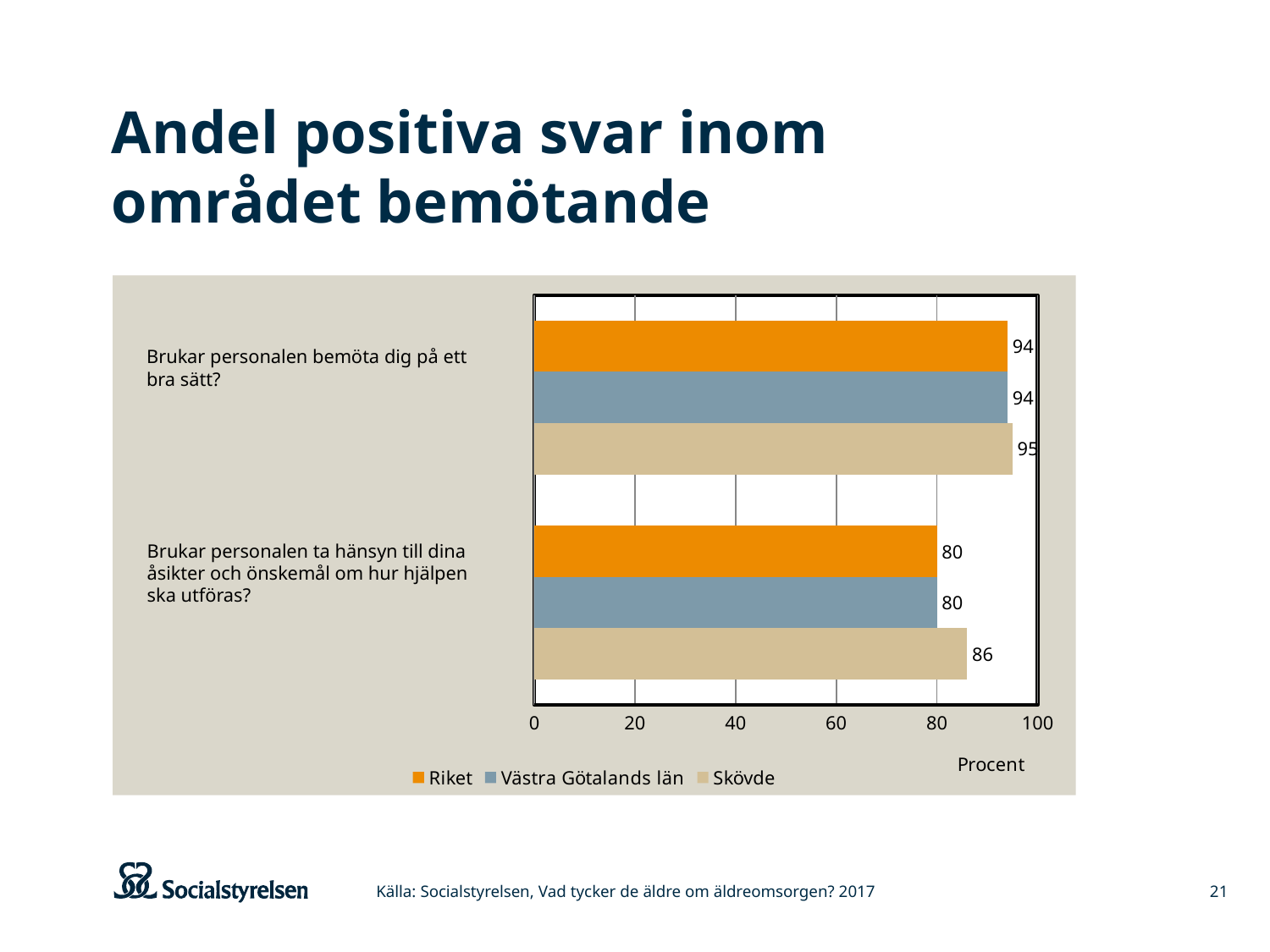
What is the difference between Skövde and Riket on the question "Brukar personalen ta hänsyn till dina åsikter och önskemål om hur hjälpen ska utföras?"? 6 How many series does the legend list? 3 What kind of chart is shown on the slide? Bar chart What is the value for Skövde on the question "Brukar personalen bemöta dig på ett bra sätt?"? 95 How many questions (categories) are shown in the chart? 2 Is the value for Riket on "Brukar personalen bemöta dig på ett bra sätt?" greater or less than 80? greater Which is larger: the Skövde value for "Brukar personalen bemöta dig på ett bra sätt?" or the Skövde value for "Brukar personalen ta hänsyn till dina åsikter och önskemål om hur hjälpen ska utföras?"? Brukar personalen bemöta dig på ett bra sätt? What is the value for Skövde on the question "Brukar personalen ta hänsyn till dina åsikter och önskemål om hur hjälpen ska utföras?"? 86 Which series has the highest value on the question "Brukar personalen ta hänsyn till dina åsikter och önskemål om hur hjälpen ska utföras?"? Skövde What is the value for Västra Götalands län on the question "Brukar personalen bemöta dig på ett bra sätt?"? 94 What unit is shown on the horizontal axis of the chart? Procent What is the value for Riket on the question "Brukar personalen ta hänsyn till dina åsikter och önskemål om hur hjälpen ska utföras?"? 80